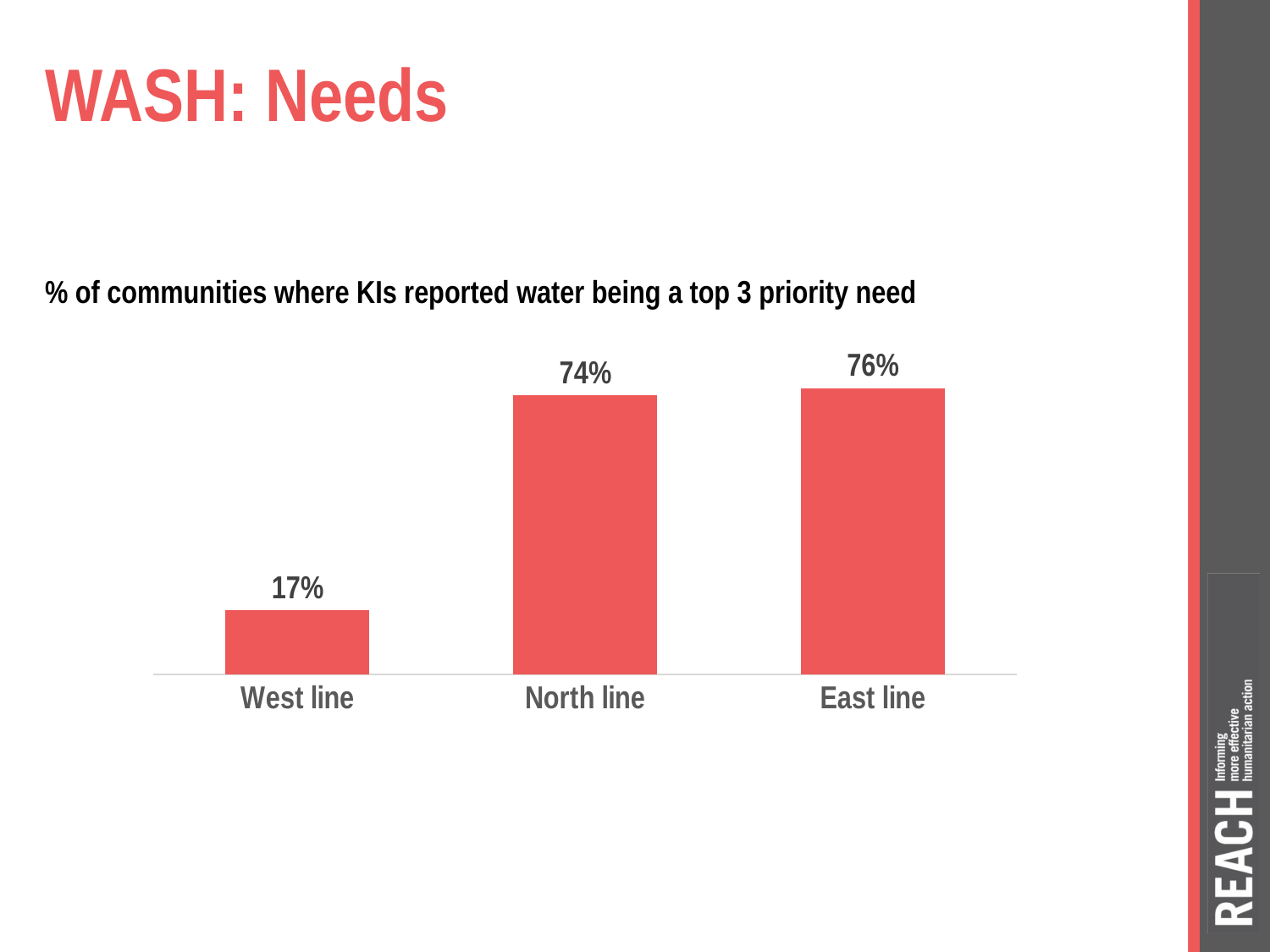
What is the title of the chart? % of communities where KIs reported water being a top 3 priority need What is the value shown for the East line? 76% What percentage of communities on the West line reported water as a top 3 priority need? 17% Which line has the highest percentage of communities reporting water as a top 3 priority need? East line Which line has the lowest percentage of communities reporting water as a top 3 priority need? West line What is the difference between the North line and West line values? 57% Which has a larger value, the North line or the West line? North line What is the value shown for the North line? 74% How many categories are shown in the chart? 3 What kind of chart is shown on the slide? Bar chart What is the difference between the East line and West line values? 59% What colour are the bars in the chart? Red